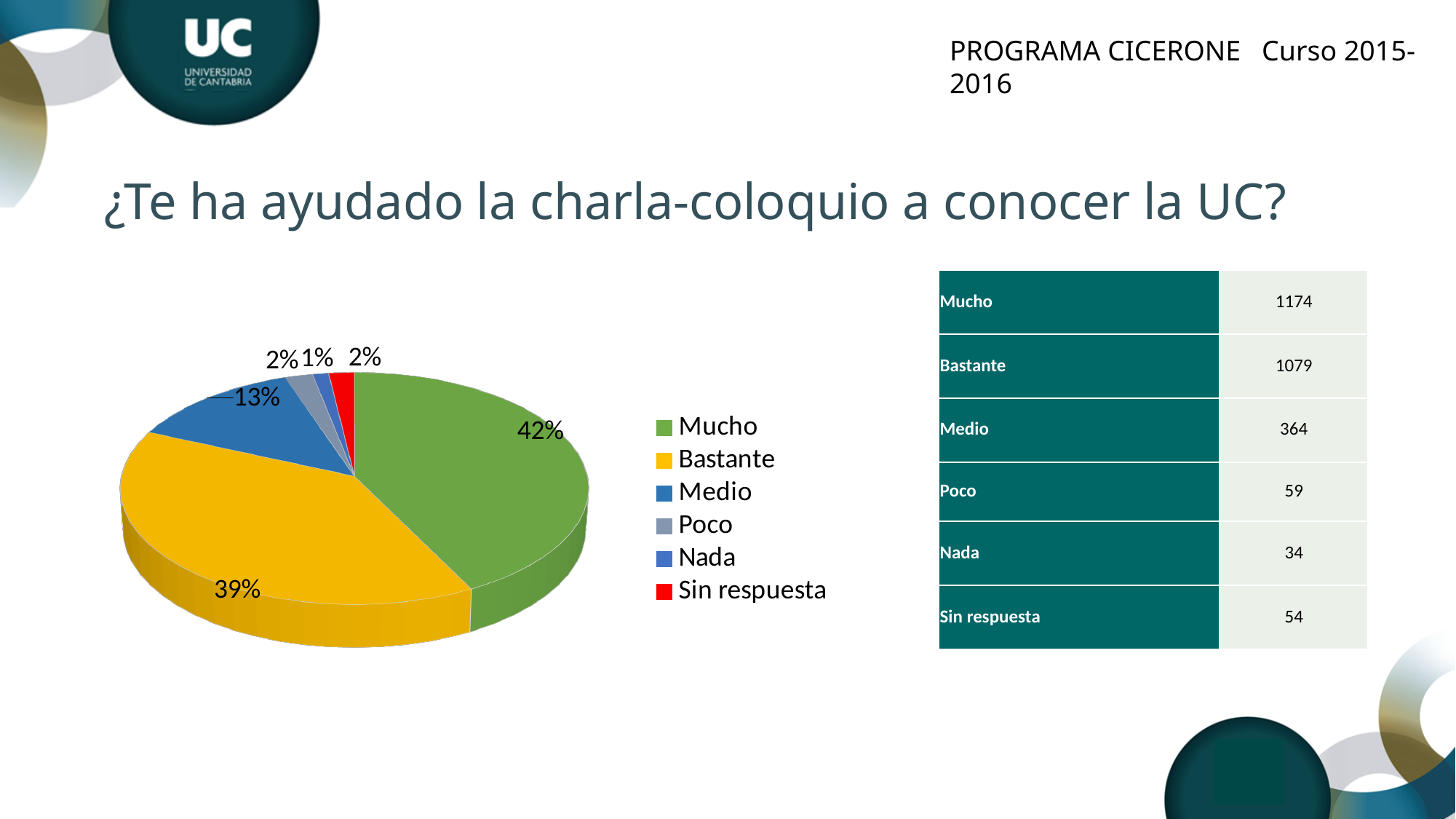
What percentage is shown for the Medio slice? 13% What percentage is shown for the Poco slice? 2% What percentage of the pie does the Mucho slice represent? 42% Which category has the largest slice of the pie? Mucho Which category has the smallest slice of the pie? Nada Which slice is larger, Medio or Bastante? Bastante What colour is the Sin respuesta slice in the pie chart? red How many categories does the pie chart have? 6 What kind of chart is shown on the slide? pie chart What is the difference in percentage points between the Mucho and Bastante slices? 3